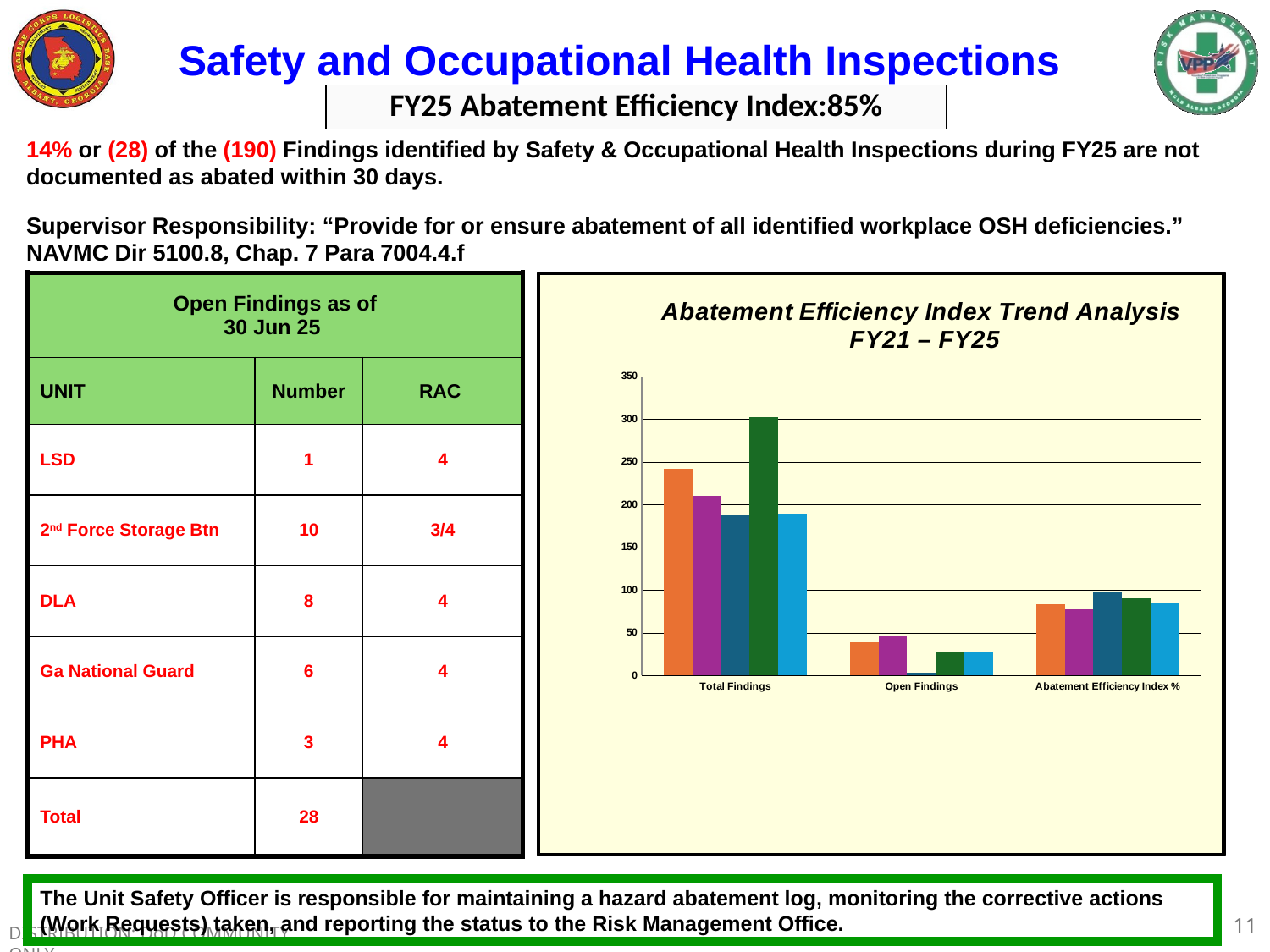
What type of chart is shown on the slide? bar chart Which category in the chart has the lowest bars overall? Open Findings Are all the bars in the Abatement Efficiency Index % category greater or less than 150? less Which category in the chart contains the tallest bar? Total Findings How many bars are plotted for each category in the chart? 5 How many categories are shown along the x axis of the chart? 3 Is the tallest bar in the Open Findings category greater or less than 50? less What is the highest value shown on the chart's vertical axis? 350 Is the tallest bar in the Total Findings category greater or less than 250? greater Which category has taller bars, Total Findings or Open Findings? Total Findings What is the title of the chart on the slide? Abatement Efficiency Index Trend Analysis FY21 – FY25